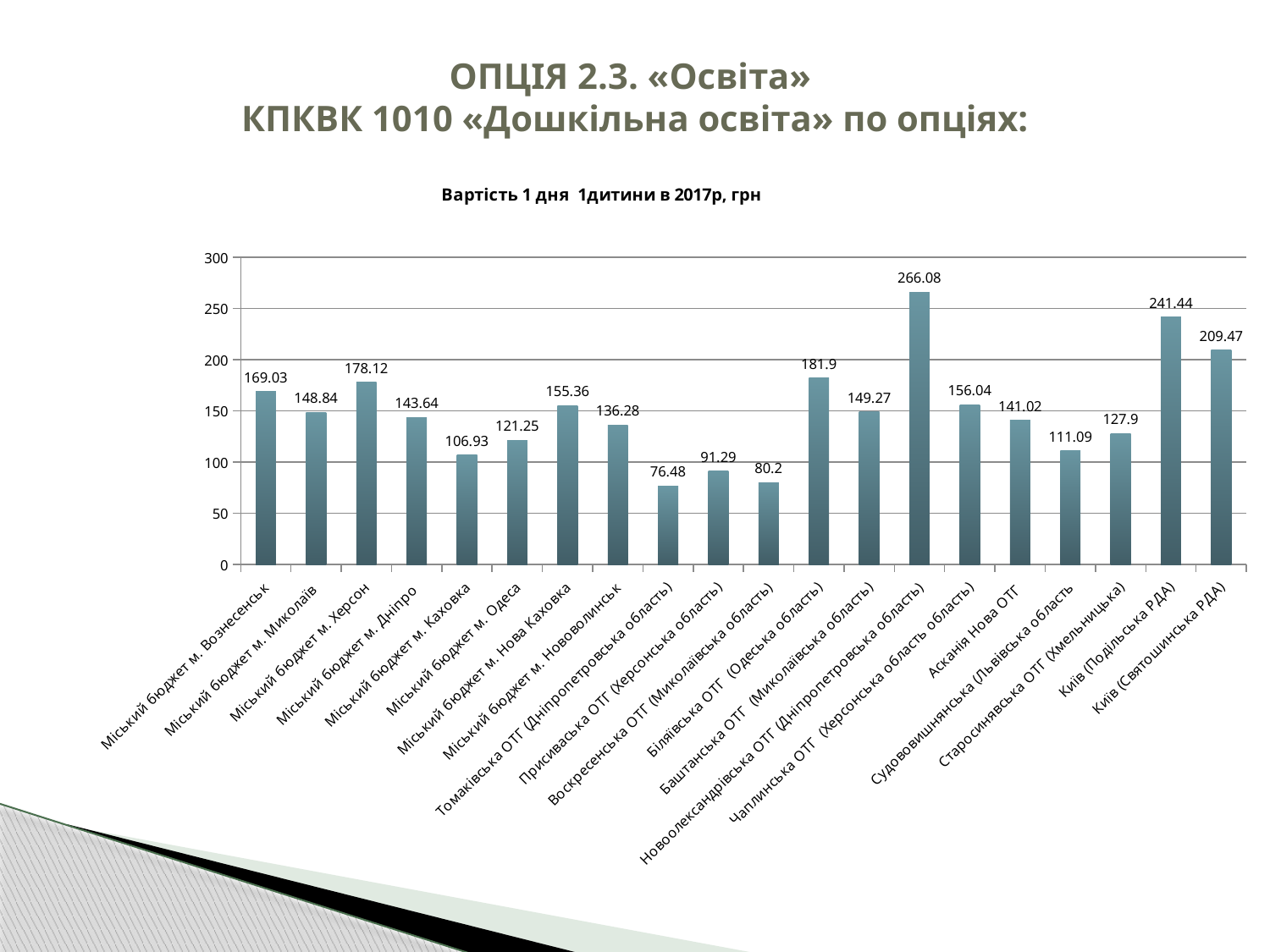
What is the value for Присиваська ОТГ (Херсонська область)? 91.29 What is the value for Міський бюджет м. Херсон? 178.12 Which is larger, the value for Міський бюджет м. Одеса or the value for Міський бюджет м. Нововолинськ? Міський бюджет м. Нововолинськ Is the value for Біляївська ОТГ (Одеська область) greater or less than 150? greater Which category has the highest value? Новоолександрівська ОТГ (Дніпропетровська область) What is the value for Київ (Подільська РДА)? 241.44 What is the difference between the values for Міський бюджет м. Вознесенськ and Міський бюджет м. Миколаїв? 20.19 What is the title of the chart? Вартість 1 дня 1дитини в 2017р, грн How many categories are shown on the chart? 20 What is the difference between the values for Київ (Подільська РДА) and Київ (Святошинська РДА)? 31.97 Which category has the lowest value? Томаківська ОТГ (Дніпропетровська область) What kind of chart is shown on the slide? bar chart